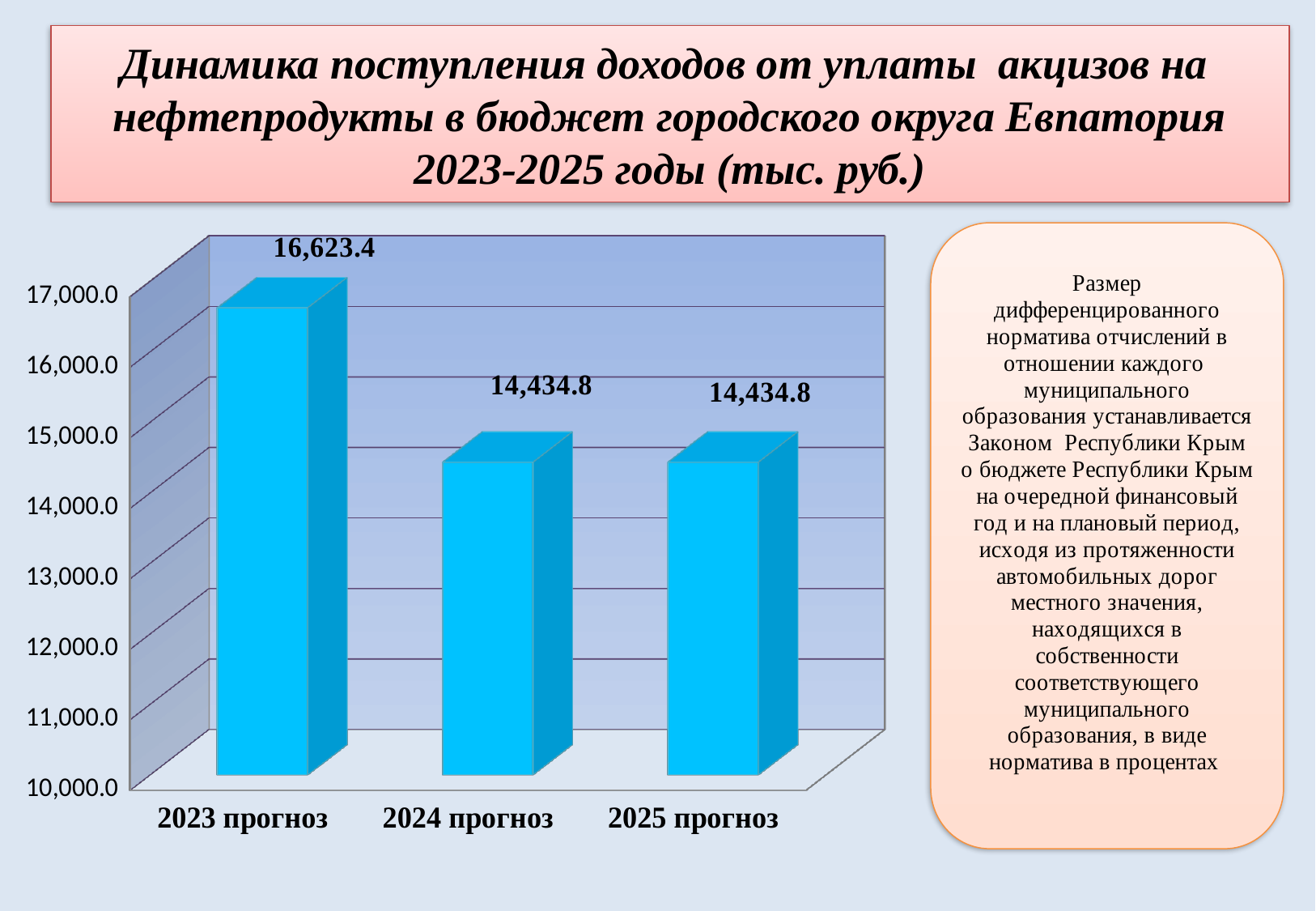
What kind of chart is shown on the slide? bar chart Is the value for 2024 прогноз greater or less than 15,000.0? less How many categories are shown on the x axis? 3 What is the value for 2025 прогноз? 14,434.8 Do the values rise or fall from 2023 прогноз to 2024 прогноз? fall Which is larger, the value for 2023 прогноз or the value for 2025 прогноз? 2023 прогноз What is the value for 2023 прогноз? 16,623.4 What is the lowest value shown on the vertical axis? 10,000.0 What is the difference between the values for 2023 прогноз and 2024 прогноз? 2,188.6 What is the value for 2024 прогноз? 14,434.8 Which category has the highest value? 2023 прогноз Is the value for 2023 прогноз greater or less than 16,000.0? greater